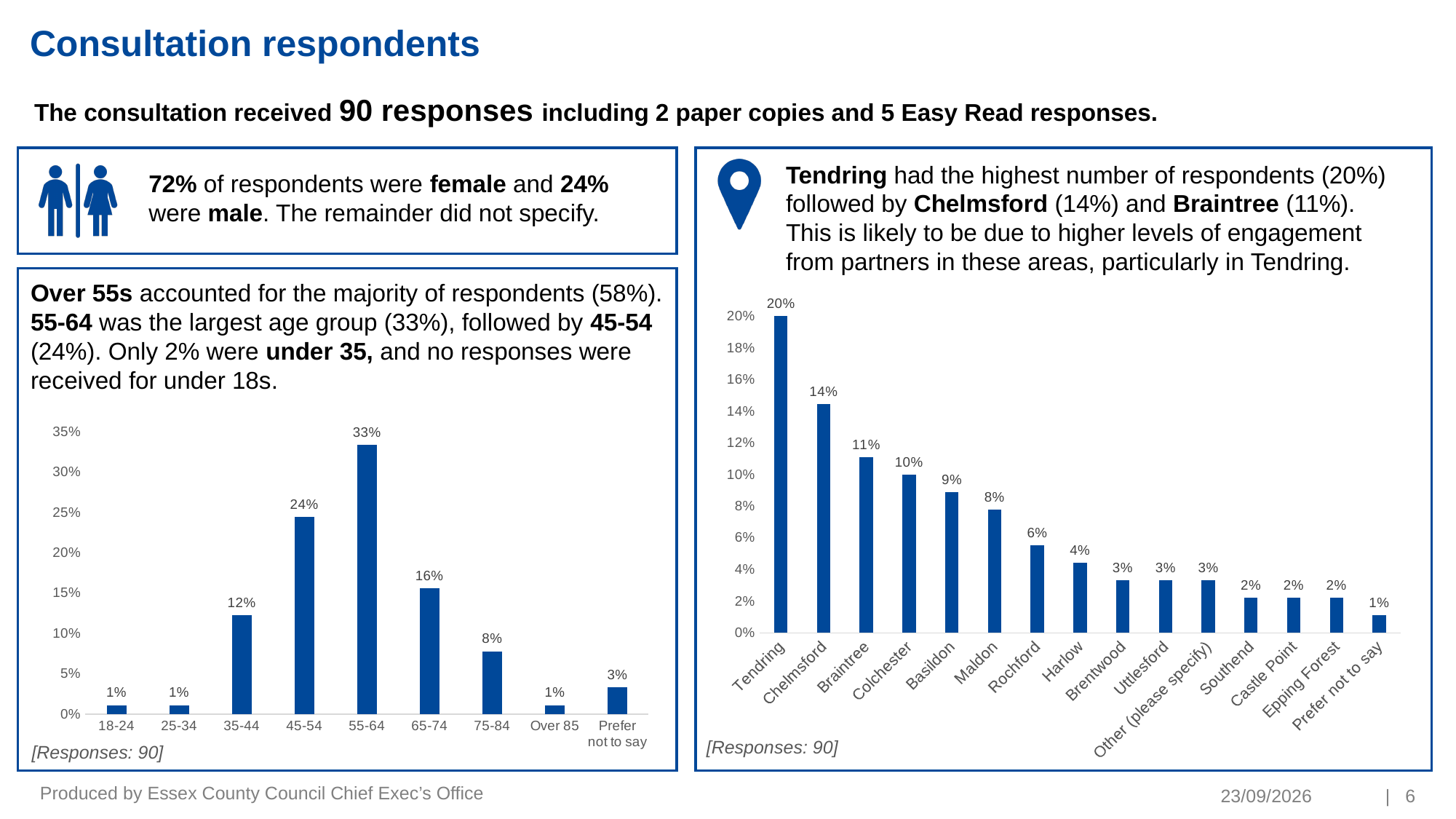
In the right chart (districts), what percentage of respondents were from Rochford? 6% In the right chart (districts), what percentage of respondents were from Colchester? 10% In the left chart (age groups), what is the difference between the 45-54 and 65-74 percentages? 8% In the right chart (districts), how many categories are shown on the x axis? 15 In the right chart (districts), which is larger, the value for Basildon or the value for Harlow? Basildon In the left chart (age groups), which age group has the highest percentage of respondents? 55-64 In the right chart (districts), what is the difference between the Tendring and Chelmsford percentages? 6% In the right chart (districts), which category has the lowest percentage? Prefer not to say In the left chart (age groups), what percentage of respondents were aged 75-84? 8% In the left chart (age groups), how many categories are shown on the x axis? 9 In the left chart (age groups), what percentage of respondents were aged 55-64? 33% In the left chart (age groups), what kind of chart is shown? Bar chart